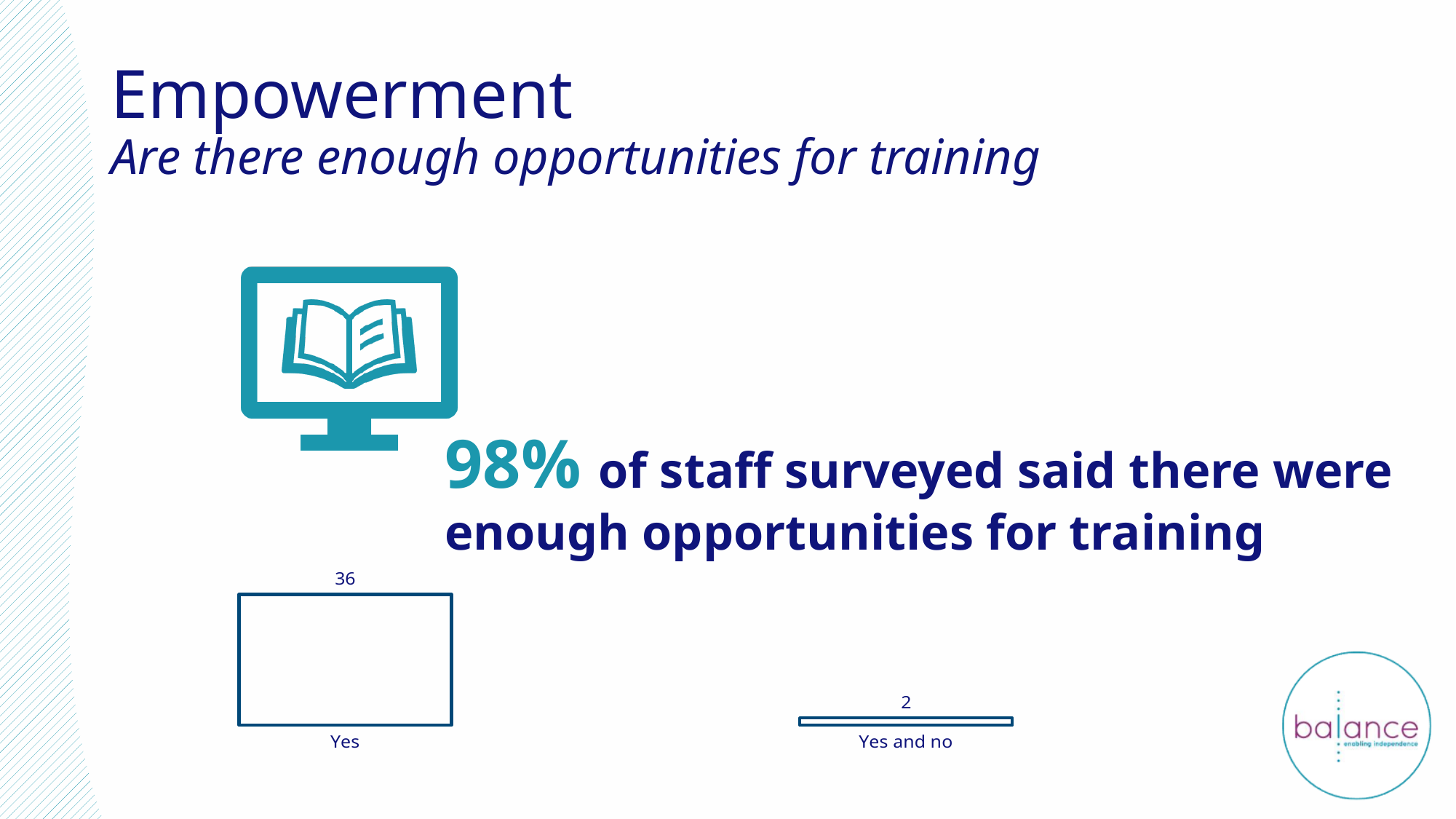
What is the value for the "Yes" category in the chart? 36 What percentage of staff surveyed said there were enough opportunities for training, according to the text next to the chart? 98% Which is larger, the value for "Yes" or the value for "Yes and no"? Yes How many categories are shown in the chart? 2 Which category has the lowest value in the chart? Yes and no What is the difference between the values for "Yes" and "Yes and no"? 34 Which category has the highest value in the chart? Yes What is the value for the "Yes and no" category in the chart? 2 What kind of chart is shown on the slide? Bar chart What is the total of the values shown in the chart? 38 What are the category labels shown on the chart's x axis? Yes; Yes and no